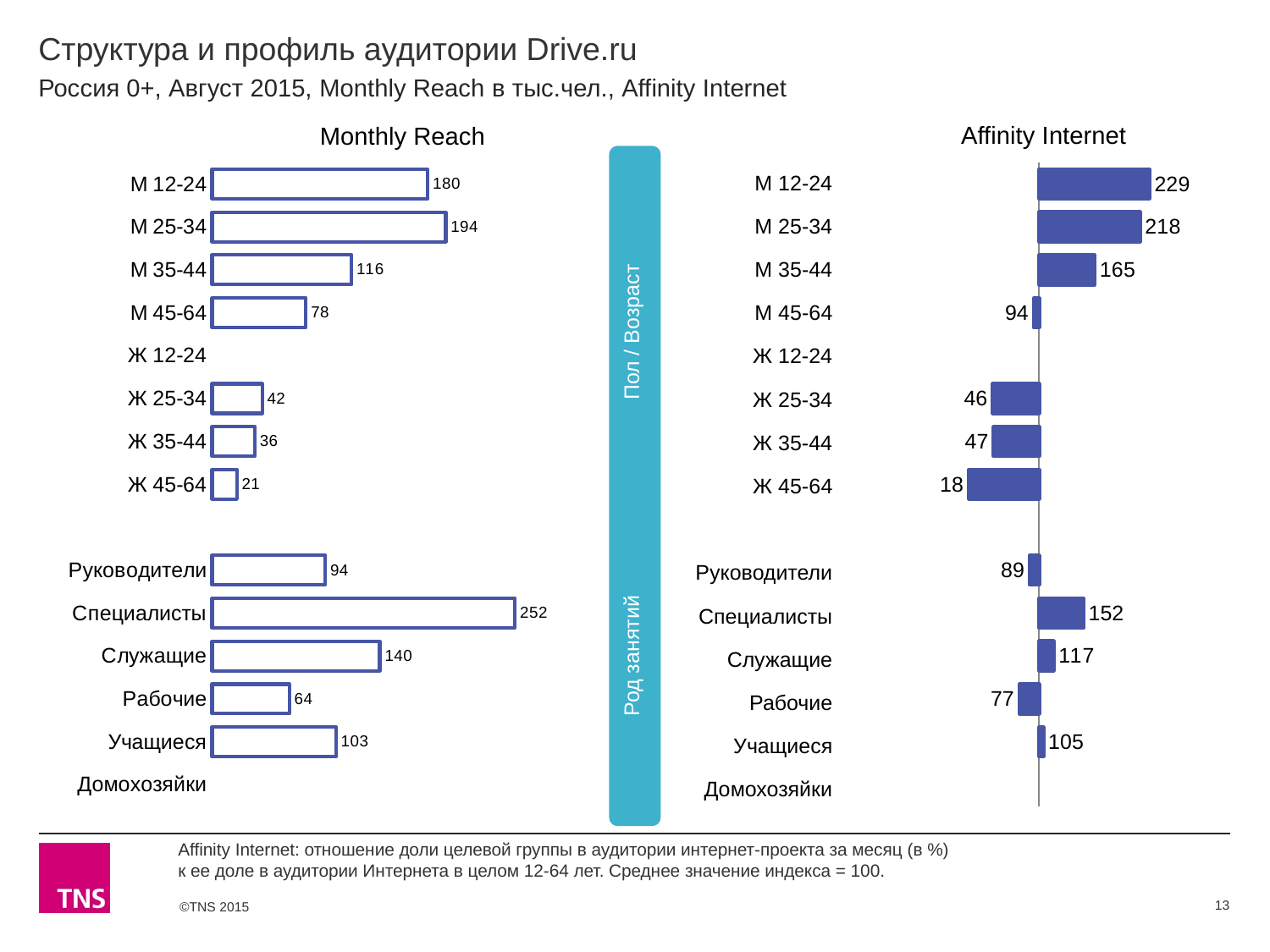
What is the title of the chart on the left side of the slide? Monthly Reach In the Affinity Internet chart, which category has the highest value? М 12-24 In the Monthly Reach chart, what is the difference between the values for М 12-24 and М 45-64? 102 In the Affinity Internet chart, which labelled category has the lowest value? Ж 45-64 What type of chart is the Affinity Internet chart? Bar chart In the Affinity Internet chart, what is the difference between the values for М 25-34 and М 35-44? 53 In the Monthly Reach chart, which category has the highest value? Специалисты In the Affinity Internet chart, what is the value for Специалисты? 152 In the Monthly Reach chart, what is the value for Ж 45-64? 21 In the Affinity Internet chart, which is larger: the value for Руководители or the value for Рабочие? Руководители In the Monthly Reach chart, what is the value for М 25-34? 194 In the Monthly Reach chart, which is larger: the value for Служащие or the value for Учащиеся? Служащие